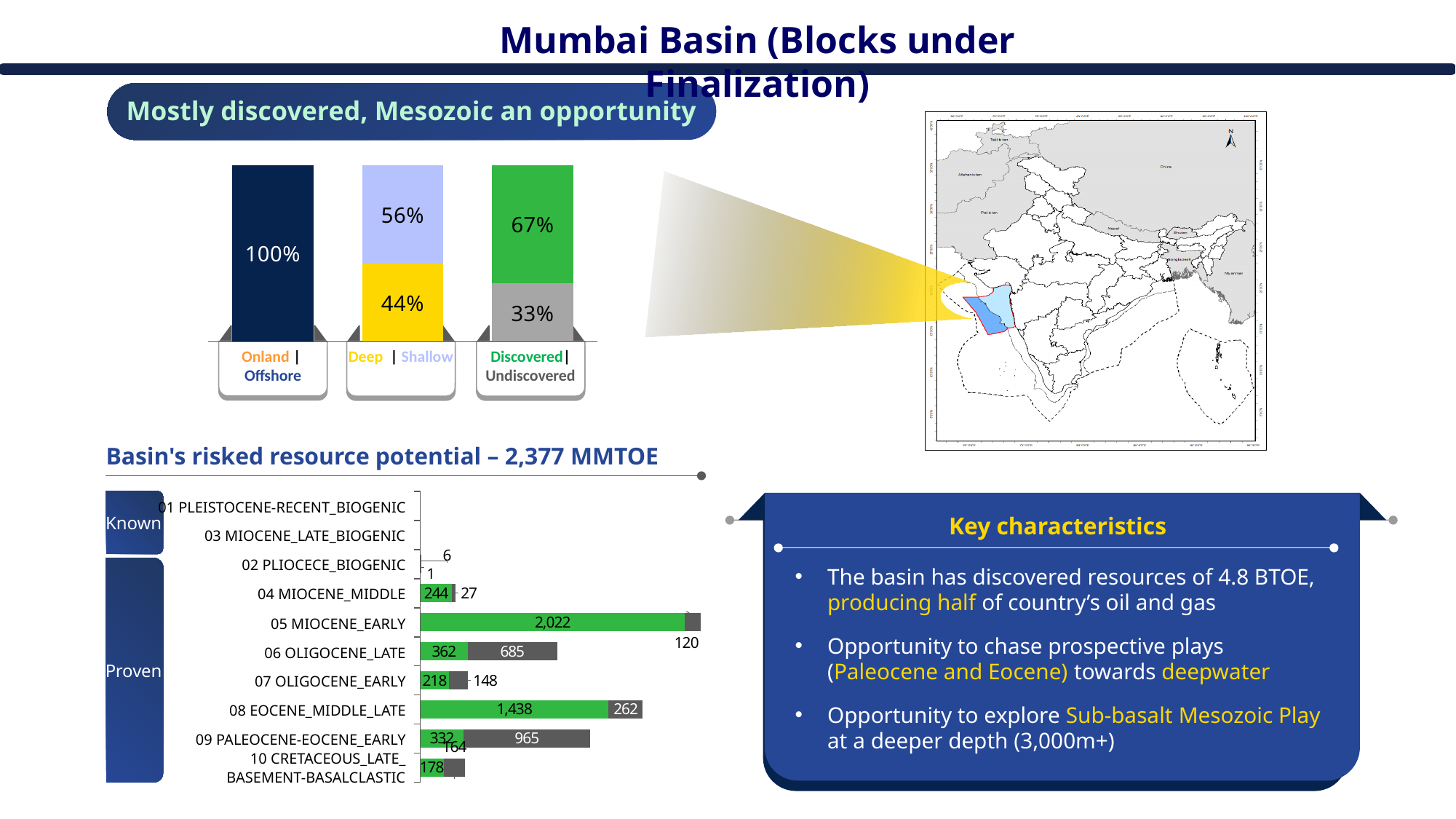
In the 'Basin's risked resource potential' chart, what is the value of the green segment for 05 MIOCENE_EARLY? 2,022 In the 'Basin's risked resource potential' chart, which category has the largest green segment? 05 MIOCENE_EARLY In the stacked bars at the top left of the slide, what percentage is shown for Discovered? 67% In the 'Basin's risked resource potential' chart, what is the value of the gray segment for 06 OLIGOCENE_LATE? 685 In the stacked bars at the top left of the slide, what percentage is shown for Deep? 44% In the 'Basin's risked resource potential' chart, what is the difference between the green segments of 08 EOCENE_MIDDLE_LATE and 09 PALEOCENE-EOCENE_EARLY? 1,106 In the 'Basin's risked resource potential' chart, what is the value of the green segment for 08 EOCENE_MIDDLE_LATE? 1,438 In the 'Basin's risked resource potential' chart, what is the total of the stacked bar for 06 OLIGOCENE_LATE? 1,047 How many categories are plotted in the 'Basin's risked resource potential' chart? 10 In the 'Basin's risked resource potential' chart, which has the larger gray segment: 09 PALEOCENE-EOCENE_EARLY or 06 OLIGOCENE_LATE? 09 PALEOCENE-EOCENE_EARLY What kind of chart is the 'Basin's risked resource potential' chart? bar chart In the 'Basin's risked resource potential' chart, what is the total of the stacked bar for 08 EOCENE_MIDDLE_LATE? 1,700